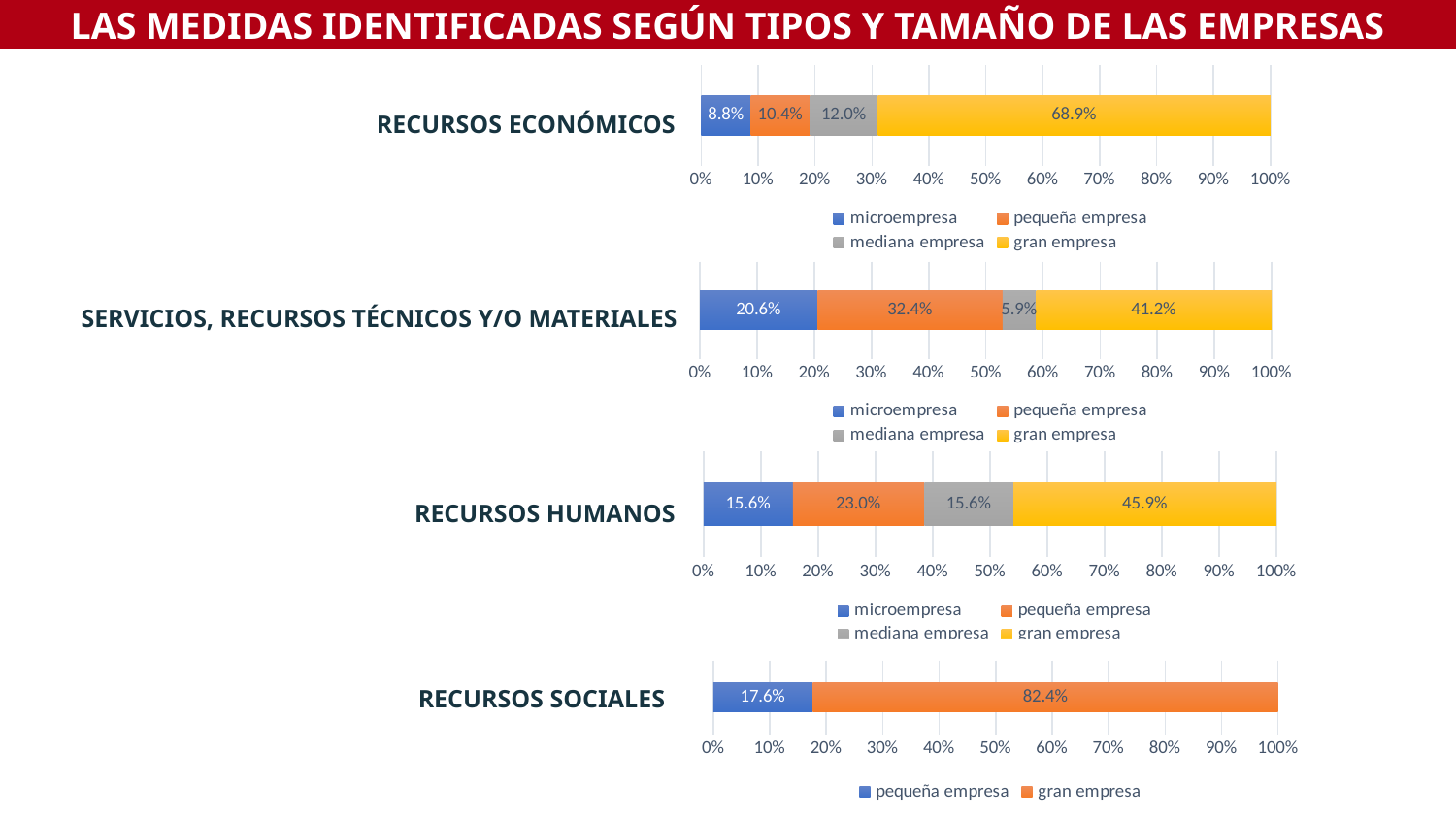
How many series does the legend of the RECURSOS HUMANOS chart list? 4 In the RECURSOS ECONÓMICOS chart, which series has the largest share? gran empresa In the RECURSOS ECONÓMICOS chart, what is the value for microempresa? 8.8% In the SERVICIOS, RECURSOS TÉCNICOS Y/O MATERIALES chart, what is the difference between gran empresa and microempresa? 20.6% In the RECURSOS HUMANOS chart, which is larger, pequeña empresa or mediana empresa? pequeña empresa In the SERVICIOS, RECURSOS TÉCNICOS Y/O MATERIALES chart, what is the value for pequeña empresa? 32.4% What kind of chart is the RECURSOS ECONÓMICOS chart? stacked bar chart In the RECURSOS SOCIALES chart, what is the value for gran empresa? 82.4% How many series does the legend of the RECURSOS SOCIALES chart list? 2 In the SERVICIOS, RECURSOS TÉCNICOS Y/O MATERIALES chart, which series has the smallest share? mediana empresa In the RECURSOS ECONÓMICOS chart, what is the value for gran empresa? 68.9% In the RECURSOS HUMANOS chart, what is the value for gran empresa? 45.9%